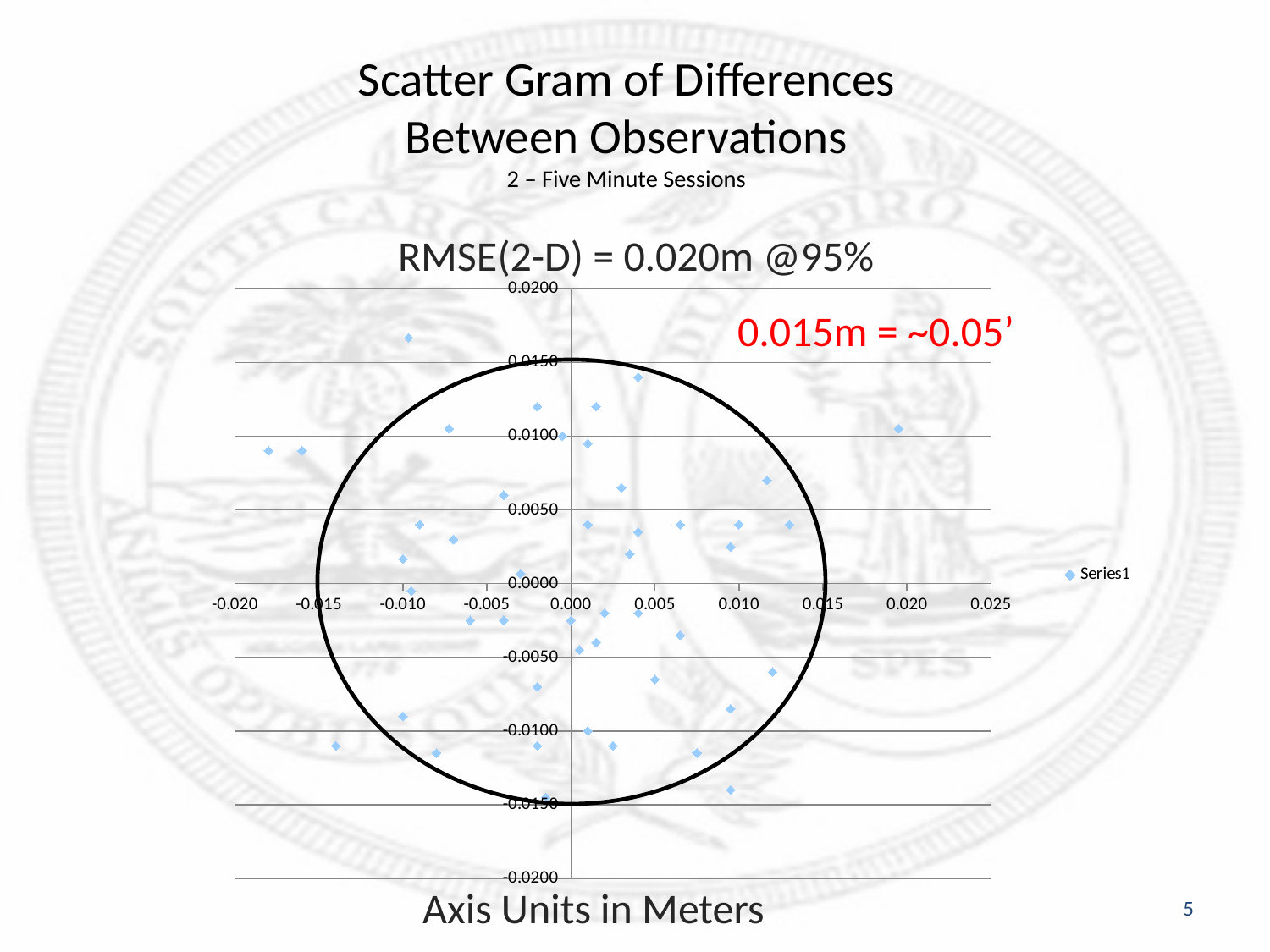
Is the y value of the highest plotted point greater or less than 0.0150? greater Is the y value of the highest plotted point greater or less than 0.0200? less Is the x value of the rightmost plotted point greater or less than 0.015? greater What is the title printed above the chart? RMSE(2-D) = 0.020m @95% What is the name of the series shown in the legend? Series1 How many series does the legend list? 1 What kind of chart is shown on the slide? scatter chart